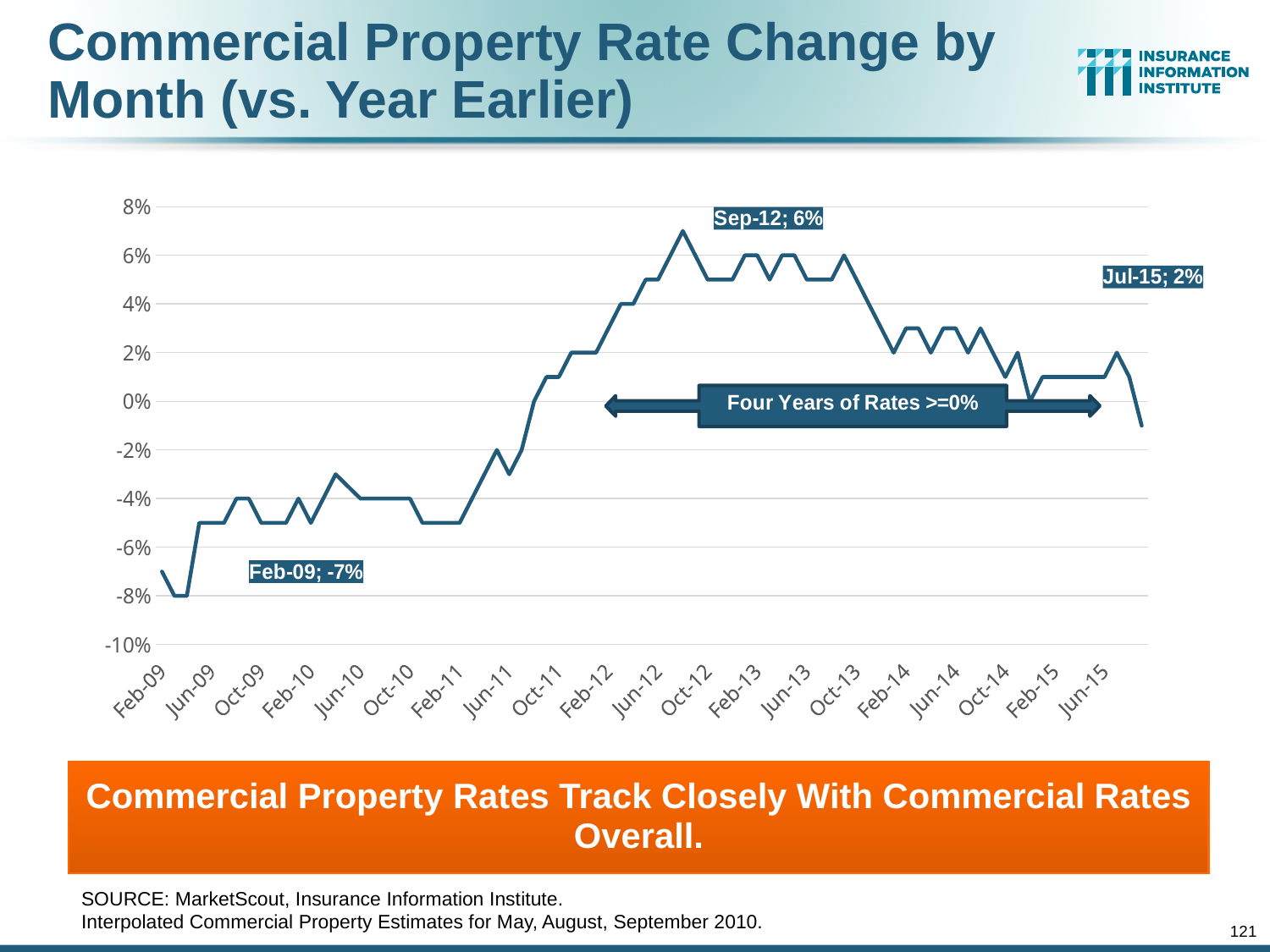
What is the commercial property rate change labeled for Sep-12? 6% Which labeled point has the lower value, Feb-09 or Jul-15? Feb-09 By how many percentage points does the labeled Sep-12 value exceed the labeled Feb-09 value? 13 percentage points Is the value for Jun-13 greater or less than 4%? greater Is the value for Oct-09 greater or less than -2%? less What kind of chart is shown on the slide? line chart Does the line generally rise or fall between Feb-09 and Sep-12? rise Which labeled point has the higher value, Sep-12 or Jul-15? Sep-12 What is the commercial property rate change labeled for Feb-09? -7% What does the horizontal arrow annotation on the chart say? Four Years of Rates >=0% By how many percentage points does the labeled Jul-15 value exceed the labeled Feb-09 value? 9 percentage points What is the commercial property rate change labeled for Jul-15? 2%